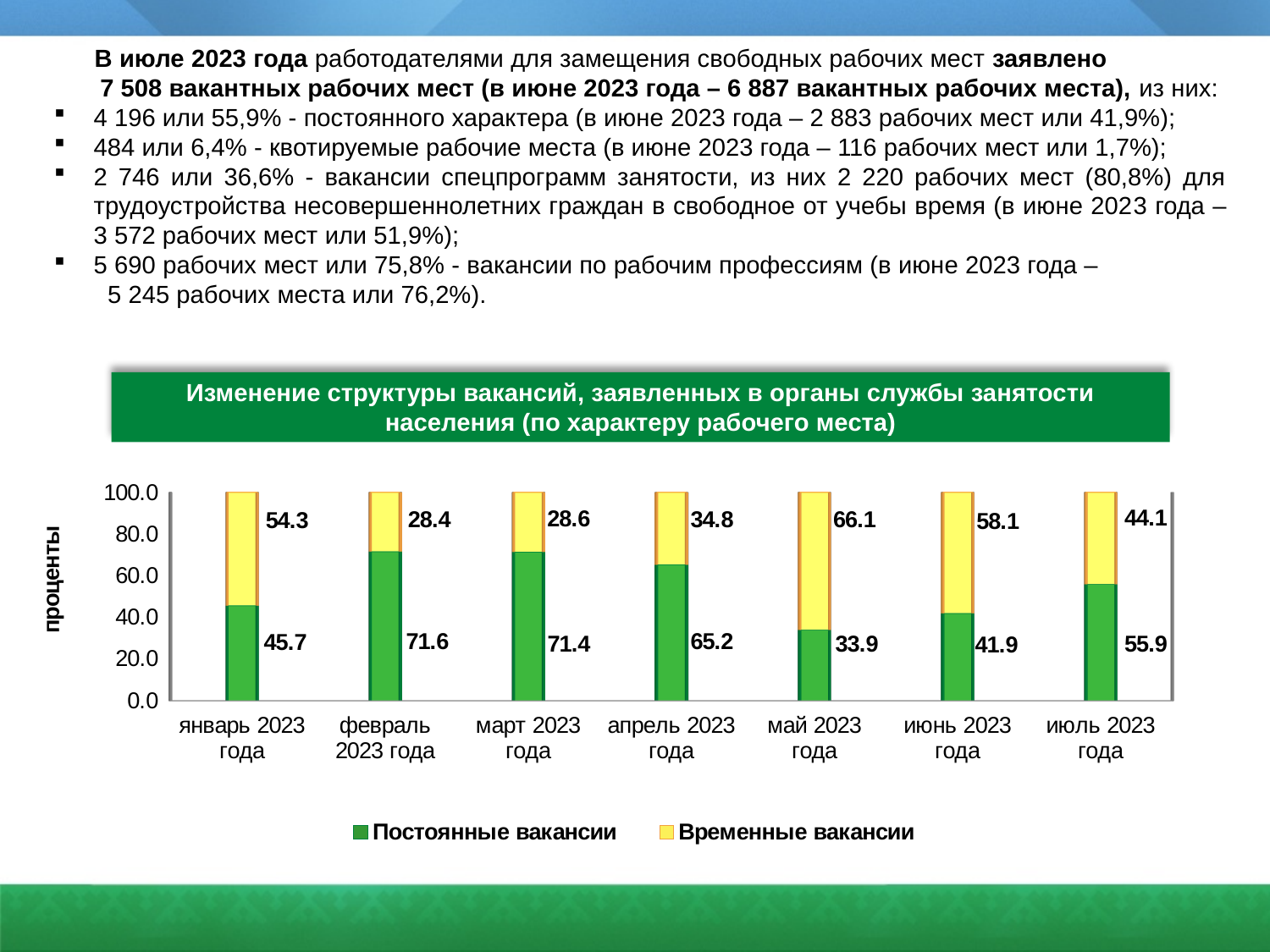
What is the difference between Временные вакансии and Постоянные вакансии in январь 2023 года? 8.6 What is the total of the stacked bar for июнь 2023 года? 100.0 How many series does the legend list? 2 What is the value for Постоянные вакансии in февраль 2023 года? 71.6 What is the value for Постоянные вакансии in июль 2023 года? 55.9 In which month is the share of Постоянные вакансии the lowest? май 2023 года How many months are shown on the x axis? 7 In which month is the share of Временные вакансии the highest? май 2023 года What is the value for Временные вакансии in май 2023 года? 66.1 What is the label of the vertical axis? проценты What kind of chart is shown? Stacked bar chart Which is larger in апрель 2023 года: Постоянные вакансии or Временные вакансии? Постоянные вакансии